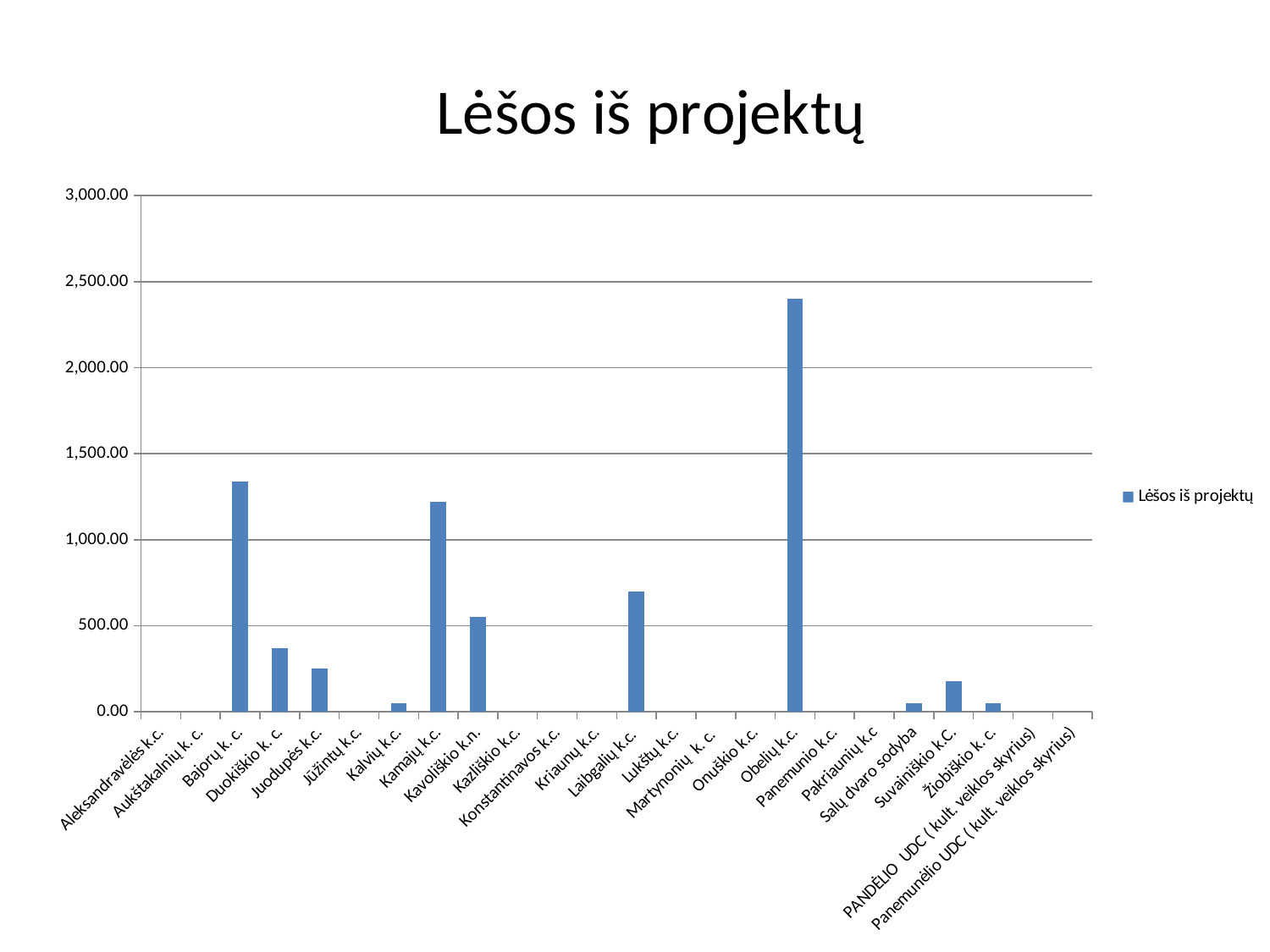
Is the value for Bajorų k. c. greater or less than 1,000.00? greater What kind of chart is shown on the slide? bar chart Which is larger, the value for Kamajų k.c. or the value for Laibgalių k.c.? Kamajų k.c. Is the value for Kavoliškio k.n. greater or less than 500.00? greater Which category has the highest value? Obelių k.c. Which is larger, the value for Kavoliškio k.n. or the value for Juodupės k.c.? Kavoliškio k.n. How many series does the legend list? 1 Is the value for Obelių k.c. greater or less than 2,000.00? greater What is the title of the chart? Lėšos iš projektų How many categories are shown on the x axis? 24